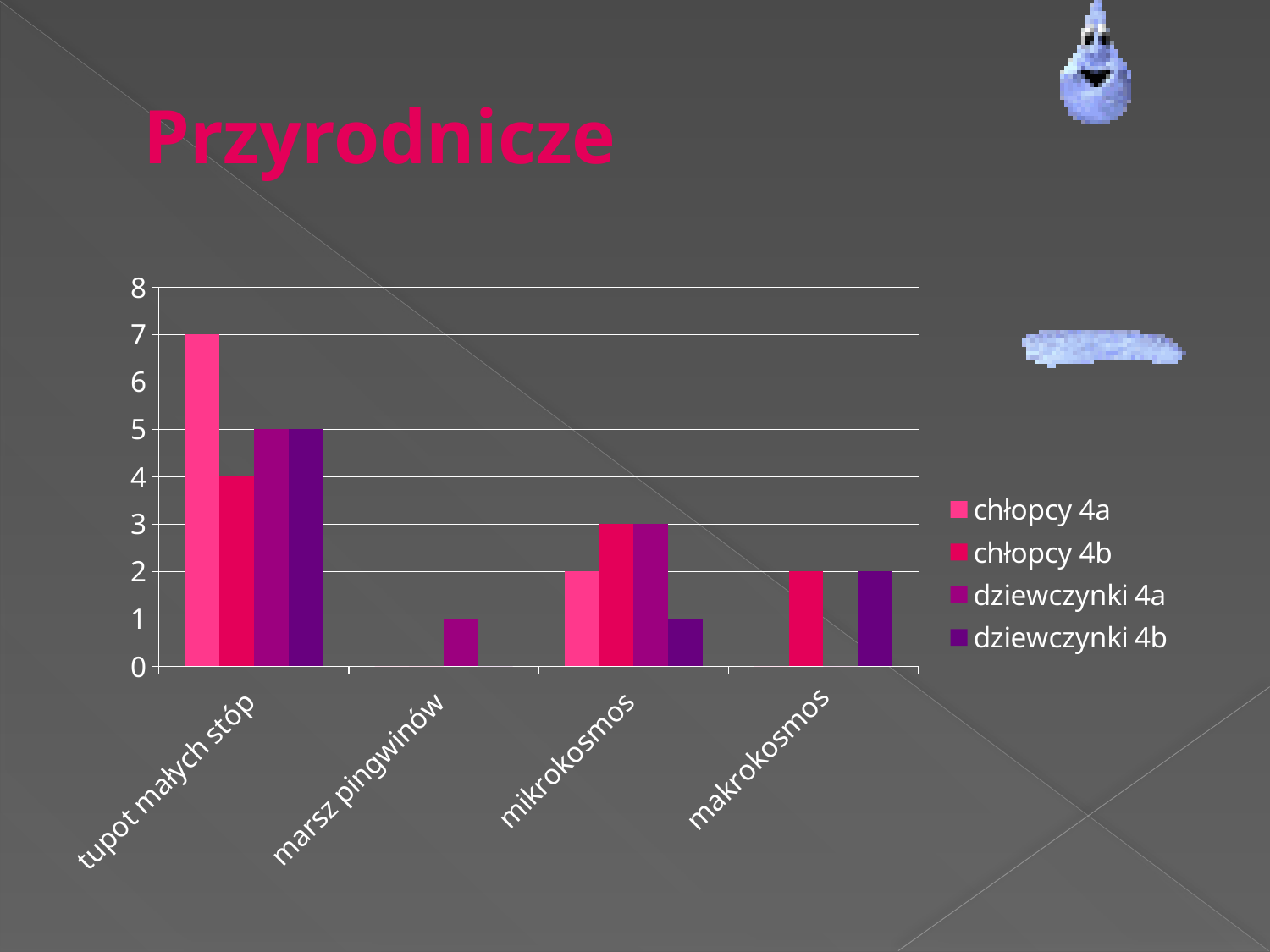
What is the value for chłopcy 4a in the category tupot małych stóp? 7 What kind of chart is shown on the slide? bar chart What is the value for chłopcy 4b in the category mikrokosmos? 3 How many categories are shown on the x axis of the chart? 4 Is the value for chłopcy 4a in the category tupot małych stóp greater or less than 5? greater How many series does the chart legend list? 4 Which category has the highest value for chłopcy 4a? tupot małych stóp Which is larger in the category mikrokosmos: the value for chłopcy 4a or the value for dziewczynki 4a? dziewczynki 4a What is the difference between the chłopcy 4a and chłopcy 4b values in the category tupot małych stóp? 3 What is the value for chłopcy 4b in the category tupot małych stóp? 4 What is the value for dziewczynki 4a in the category marsz pingwinów? 1 What is the title of the slide containing the chart? Przyrodnicze